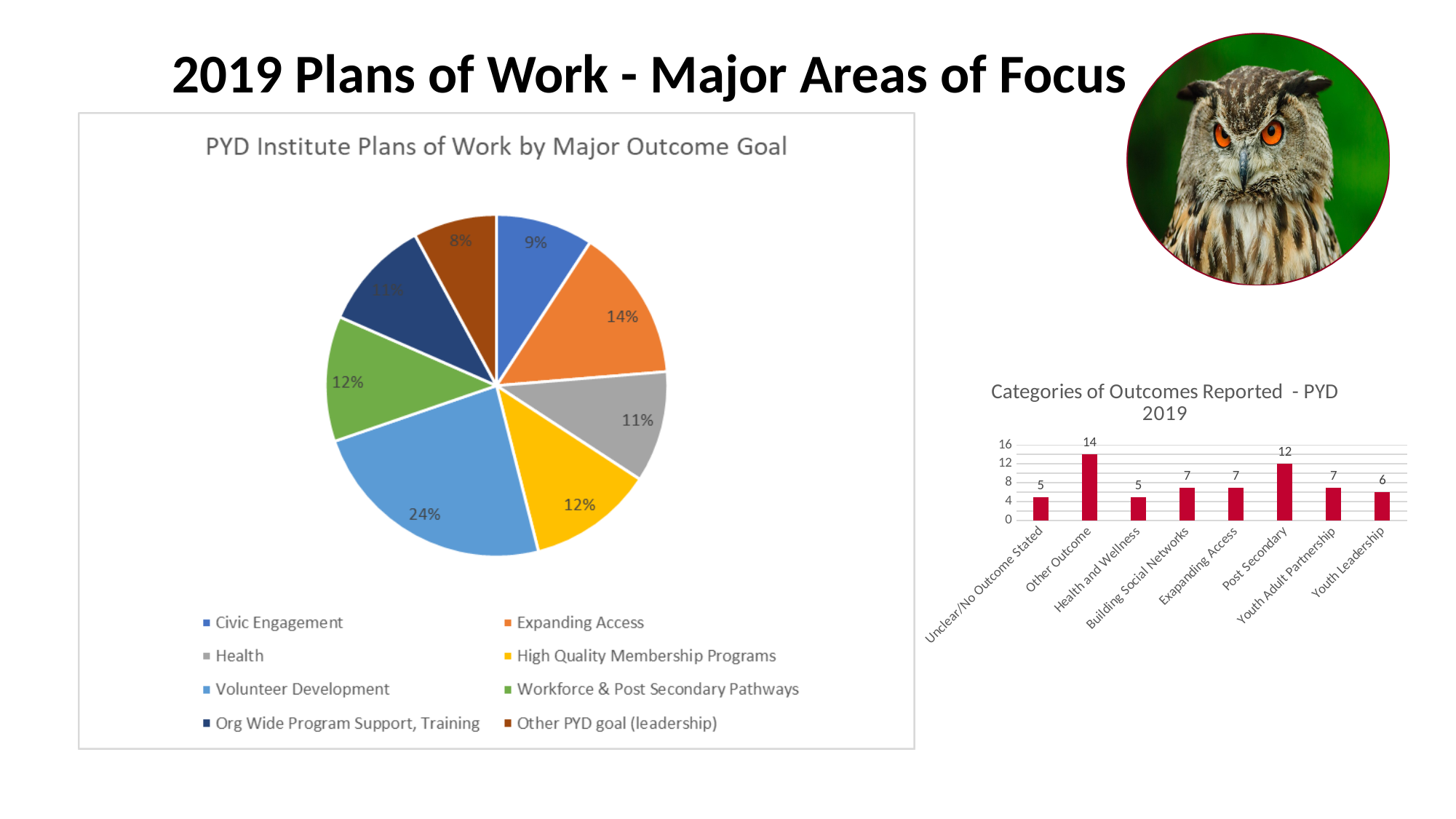
In the pie chart 'PYD Institute Plans of Work by Major Outcome Goal', what share does Volunteer Development have? 24% In the bar chart 'Categories of Outcomes Reported - PYD 2019', what is the difference between Other Outcome and Youth Leadership? 8 In the bar chart 'Categories of Outcomes Reported - PYD 2019', which is larger, Building Social Networks or Health and Wellness? Building Social Networks In the bar chart 'Categories of Outcomes Reported - PYD 2019', which category has the highest value? Other Outcome In the bar chart 'Categories of Outcomes Reported - PYD 2019', how many categories are shown on the x axis? 8 In the bar chart 'Categories of Outcomes Reported - PYD 2019', what is the value for Post Secondary? 12 In the pie chart 'PYD Institute Plans of Work by Major Outcome Goal', which category has the largest share? Volunteer Development In the pie chart 'PYD Institute Plans of Work by Major Outcome Goal', what is the difference in percentage points between Volunteer Development and Civic Engagement? 15 What kind of chart is 'Categories of Outcomes Reported - PYD 2019'? Bar chart In the pie chart 'PYD Institute Plans of Work by Major Outcome Goal', which category has the smallest share? Other PYD goal (leadership) In the pie chart 'PYD Institute Plans of Work by Major Outcome Goal', what share does Expanding Access have? 14% In the pie chart 'PYD Institute Plans of Work by Major Outcome Goal', how many categories does the legend list? 8